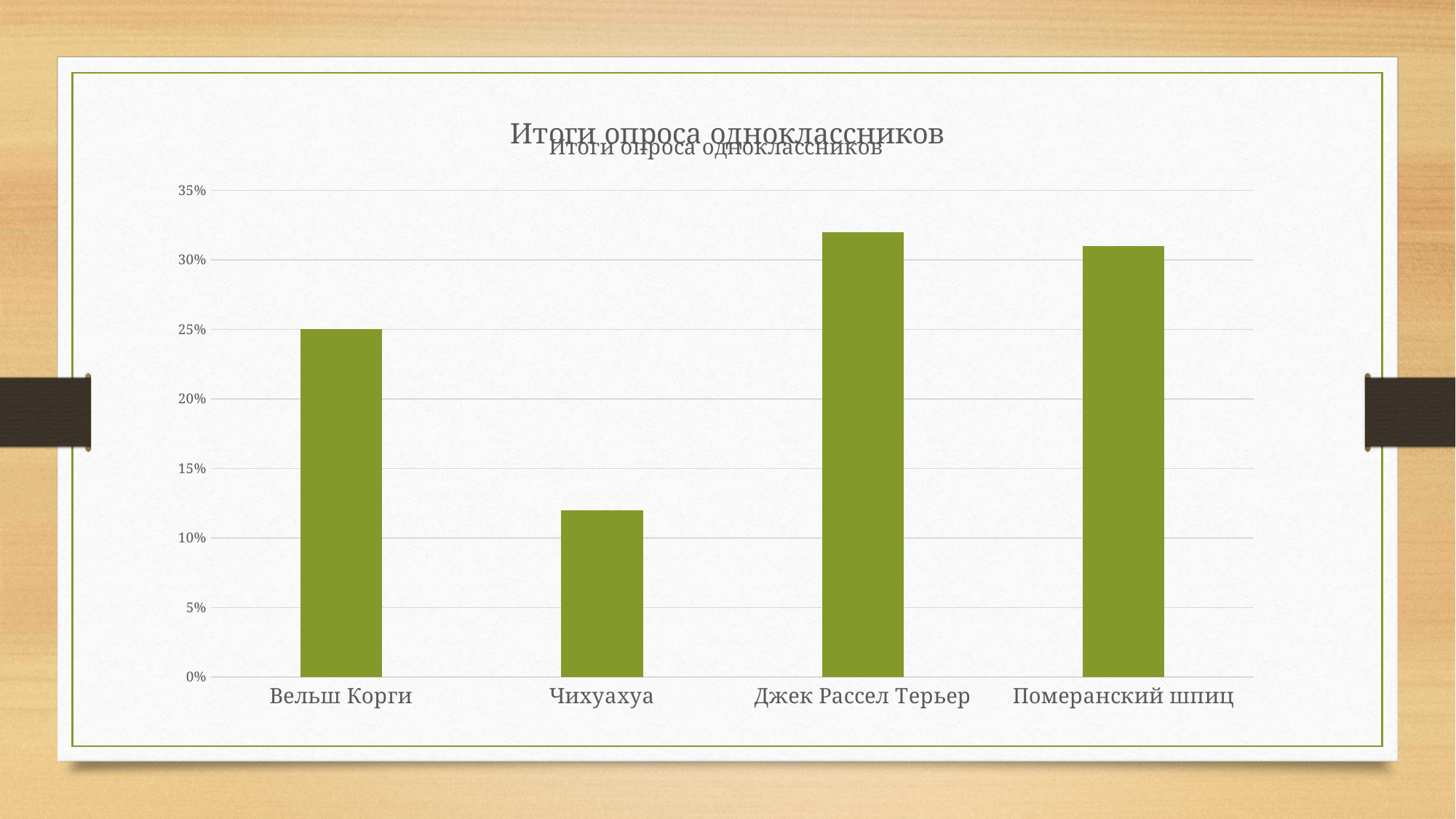
How many categories (dog breeds) are shown on the chart? 4 What is the title of the chart? Итоги опроса одноклассников What is the highest value shown on the vertical axis? 35% Is the value for Чихуахуа greater or less than 15%? less Which category has the lowest value? Чихуахуа What kind of chart is shown on the slide? bar chart Is the value for Джек Рассел Терьер greater or less than 30%? greater Which is larger, the value for Джек Рассел Терьер or the value for Вельш Корги? Джек Рассел Терьер Is the value for Померанский шпиц greater or less than 25%? greater Which is larger, the value for Вельш Корги or the value for Чихуахуа? Вельш Корги What is the value for Вельш Корги? 25%